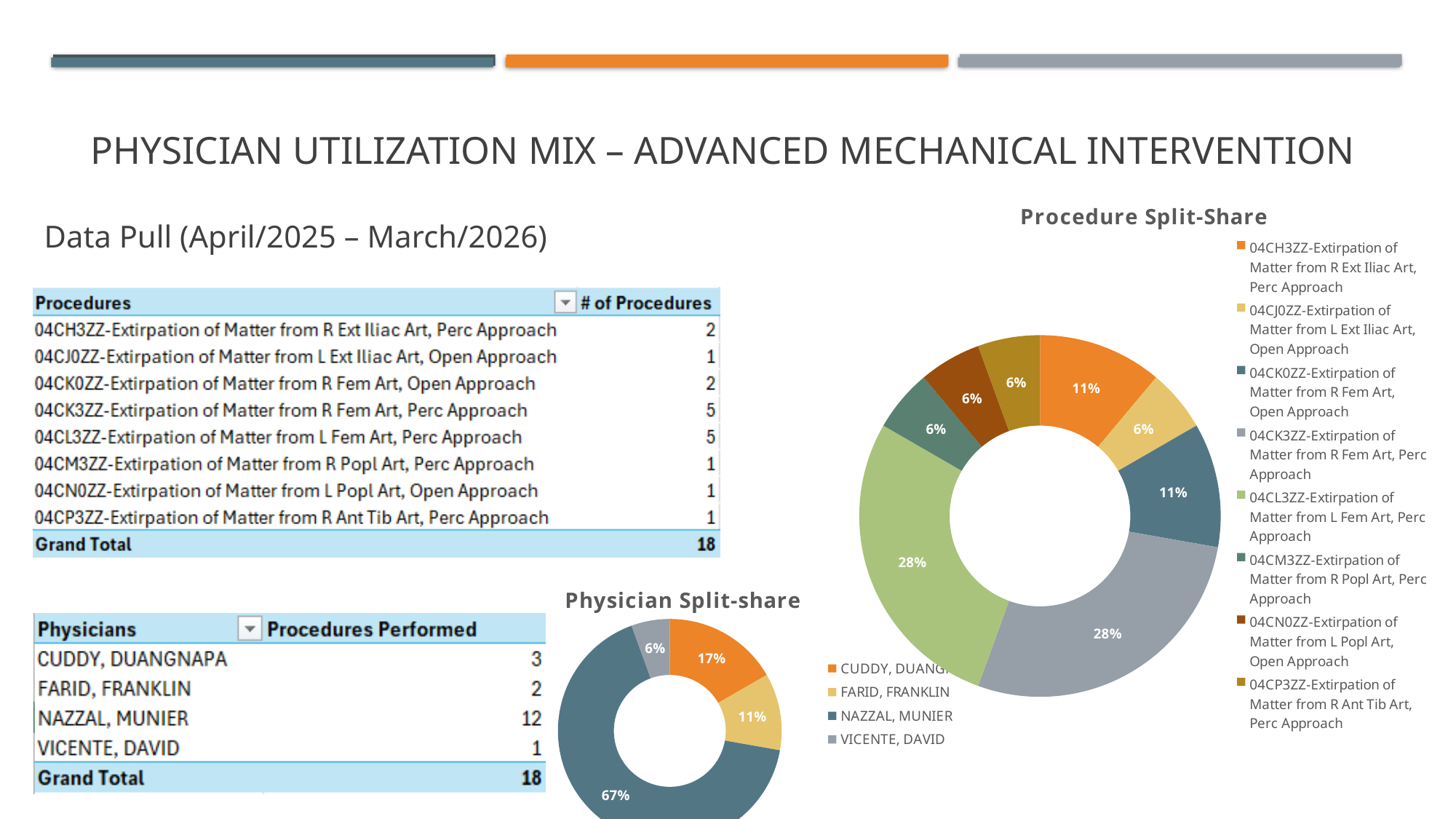
In the Procedure Split-Share chart, what colour is the slice for 04CL3ZZ-Extirpation of Matter from L Fem Art, Perc Approach? light green In the Procedure Split-Share chart, what share does 04CK3ZZ-Extirpation of Matter from R Fem Art, Perc Approach hold? 28% In the Procedure Split-Share chart, what share does 04CH3ZZ-Extirpation of Matter from R Ext Iliac Art, Perc Approach hold? 11% In the Physician Split-share chart, what share does NAZZAL, MUNIER hold? 67% In the Physician Split-share chart, what is the difference in percentage points between NAZZAL, MUNIER and FARID, FRANKLIN? 56 What kind of chart is the Procedure Split-Share chart? pie chart (donut) In the Physician Split-share chart, which physician has the smallest share? VICENTE, DAVID In the Physician Split-share chart, how many physicians does the legend list? 4 In the Procedure Split-Share chart, which is larger: the share for 04CK0ZZ-Extirpation of Matter from R Fem Art, Open Approach or the share for 04CJ0ZZ-Extirpation of Matter from L Ext Iliac Art, Open Approach? 04CK0ZZ-Extirpation of Matter from R Fem Art, Open Approach In the Physician Split-share chart, which physician has the largest share? NAZZAL, MUNIER In the Procedure Split-Share chart, how many procedure categories does the legend list? 8